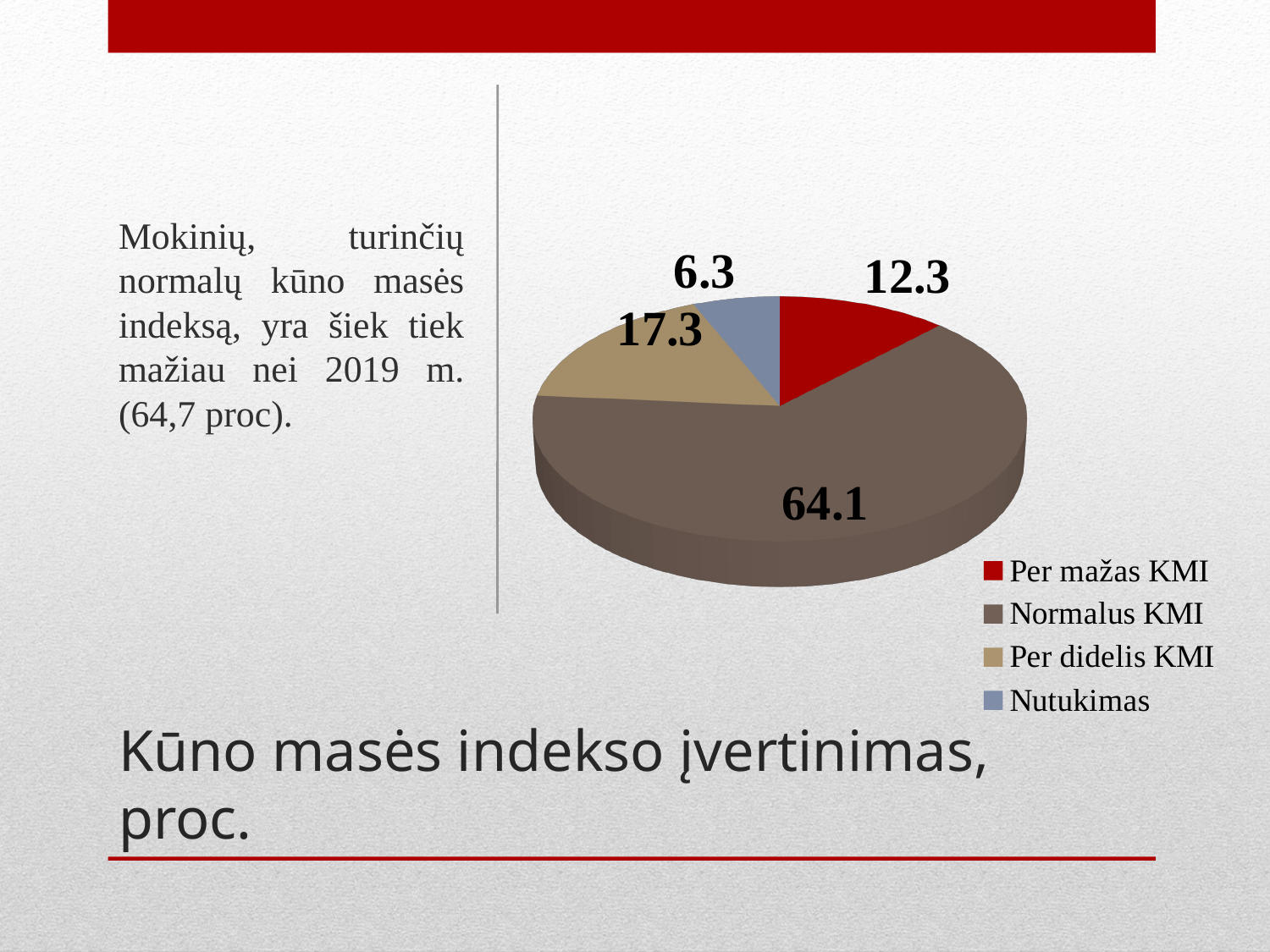
What kind of chart is shown on the slide? pie chart What is the value for Nutukimas? 6.3 Which category has the smallest slice? Nutukimas What is the difference between the values for Normalus KMI and Per didelis KMI? 46.8 What is the value for Per mažas KMI? 12.3 How many categories does the pie chart show? 4 Which category has the largest slice? Normalus KMI What colour is the slice for Per mažas KMI? red Which is larger, the value for Per didelis KMI or the value for Nutukimas? Per didelis KMI What is the value for Per didelis KMI? 17.3 What is the value for Normalus KMI? 64.1 What is the difference between the values for Per didelis KMI and Per mažas KMI? 5